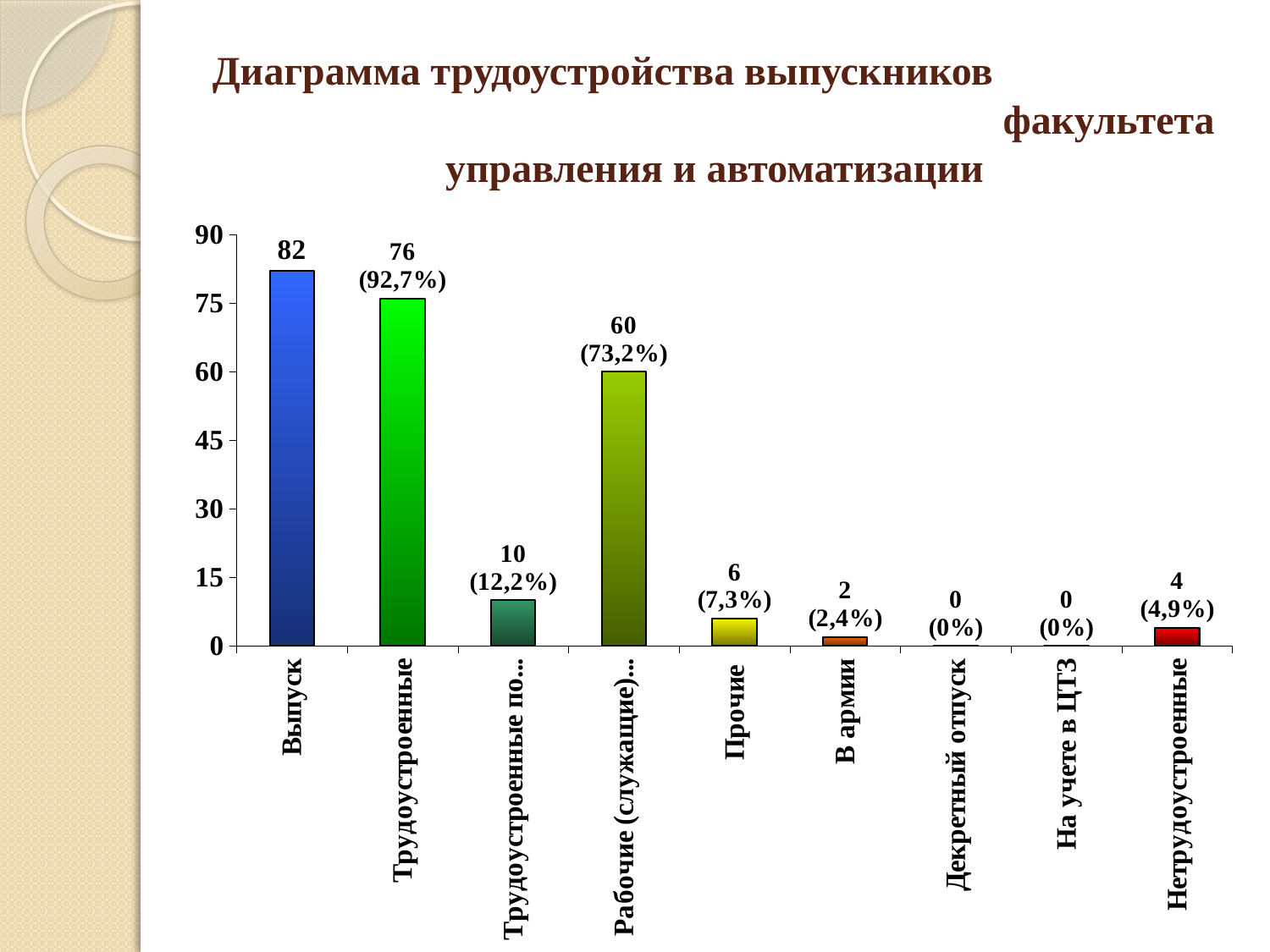
What percentage is shown for В армии? 2,4% What is the value for Декретный отпуск? 0 What is the value for Трудоустроенные? 76 Which is larger, the value for Прочие or the value for Нетрудоустроенные? Прочие What kind of chart is shown on the slide? bar chart What is the difference between the values for Выпуск and Трудоустроенные? 6 What is the value for Выпуск? 82 Which category has the highest value? Выпуск What percentage is shown for Трудоустроенные? 92,7% How many categories are shown on the x axis of the chart? 9 What is the value for Нетрудоустроенные? 4 How many categories have a value of 0? 2